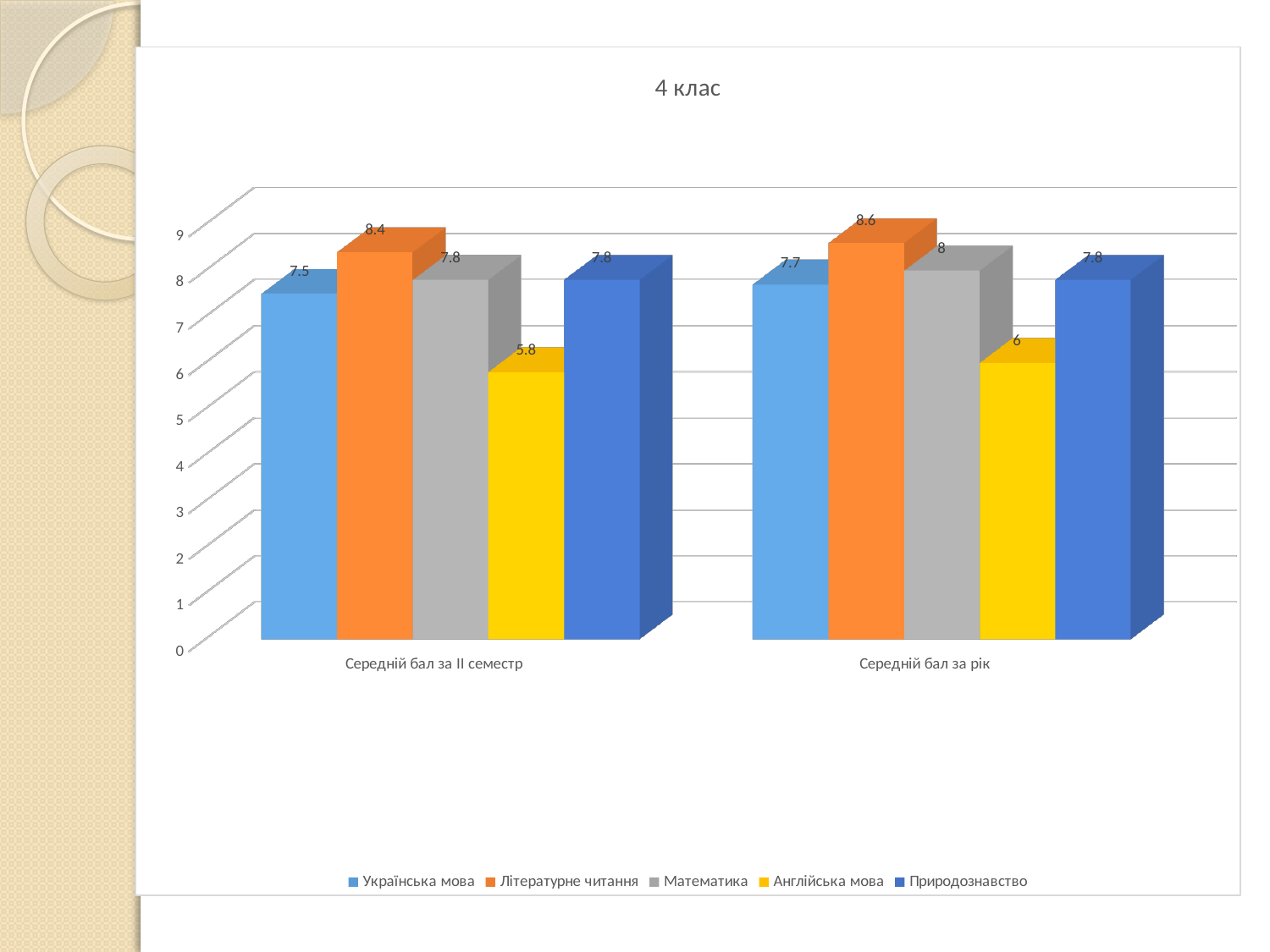
How many categories are shown on the x axis? 2 How many series does the legend list? 5 What is the difference between Літературне читання and Англійська мова in the Середній бал за ІІ семестр group? 2.6 Which series has the highest value in the Середній бал за рік group? Літературне читання Which series has the lowest value in the Середній бал за ІІ семестр group? Англійська мова What is the value for Англійська мова in the Середній бал за рік group? 6 Is the value for Природознавство in the Середній бал за рік group greater or less than 7? greater Which is larger: Математика for Середній бал за ІІ семестр or Математика for Середній бал за рік? Середній бал за рік What is the value for Українська мова in the Середній бал за рік group? 7.7 What is the title of the chart? 4 клас What kind of chart is shown on the slide? bar chart What is the value for Літературне читання in the Середній бал за ІІ семестр group? 8.4